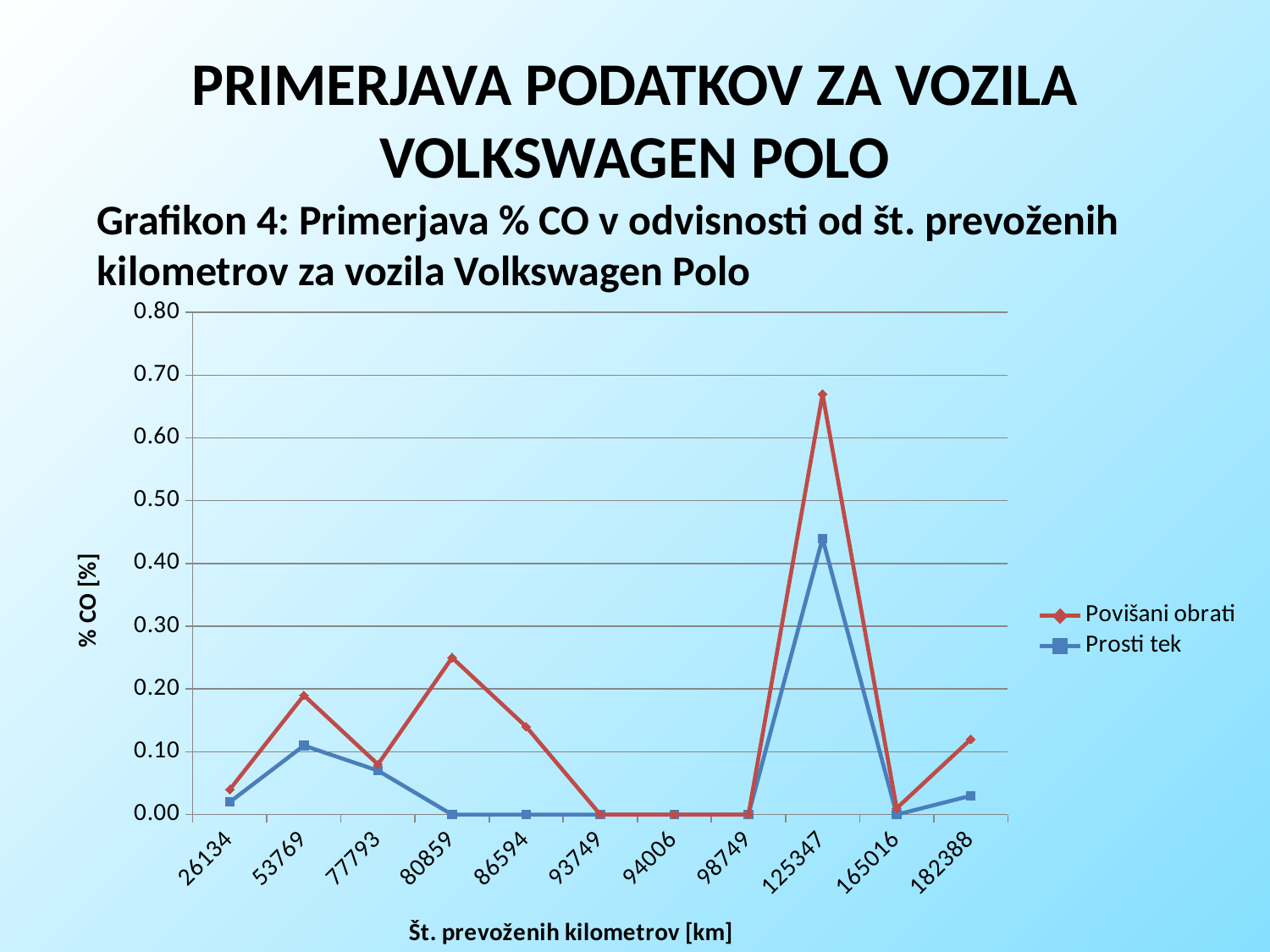
Is the Prosti tek value at 77793 km greater or less than 0.10? less What kind of chart is shown on the slide? line chart What is the Prosti tek value at 93749 km? 0.00 At 125347 km, which series has the higher % CO, Povišani obrati or Prosti tek? Povišani obrati Is the Povišani obrati value at 125347 km greater or less than 0.60? greater At which kilometre value does the Prosti tek series reach its highest % CO? 125347 What is the title of the y axis? % CO [%] Is the Prosti tek value at 125347 km greater or less than 0.40? greater How many kilometre categories are shown on the x axis? 11 How many series does the legend list? 2 At which kilometre value does the Povišani obrati series reach its highest % CO? 125347